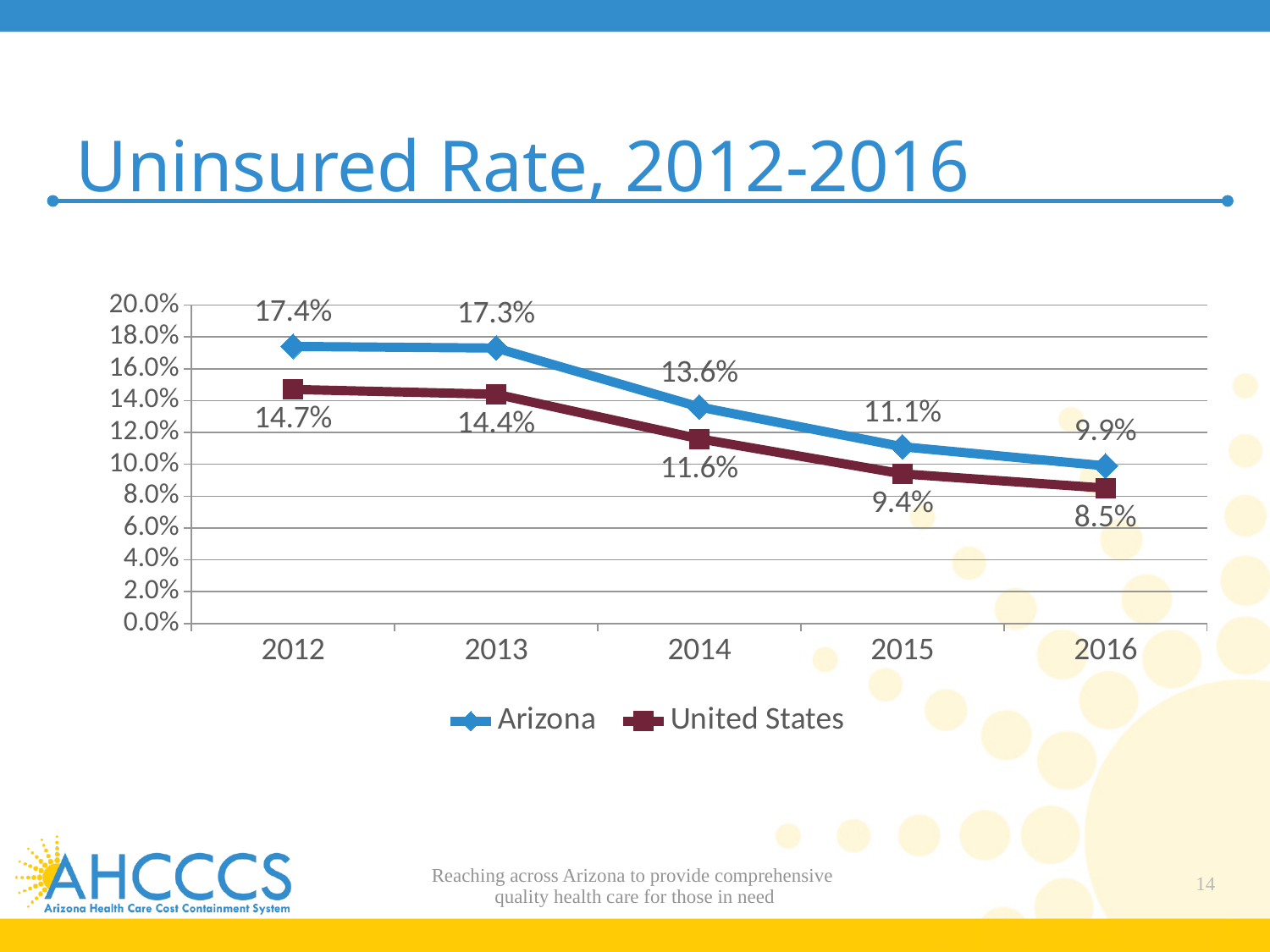
How many years are plotted on the x axis? 5 What was the uninsured rate for the United States in 2016? 8.5% How many series does the legend list? 2 Does the Arizona uninsured rate rise or fall from 2012 to 2016? Fall What was the uninsured rate for Arizona in 2014? 13.6% In which year was the United States uninsured rate lowest? 2016 What was the uninsured rate for Arizona in 2012? 17.4% Which had a higher uninsured rate in 2014, Arizona or the United States? Arizona In which year was the Arizona uninsured rate highest? 2012 What kind of chart is shown on the slide? Line chart What was the uninsured rate for the United States in 2013? 14.4% What is the difference between the Arizona and United States uninsured rates in 2015? 1.7%